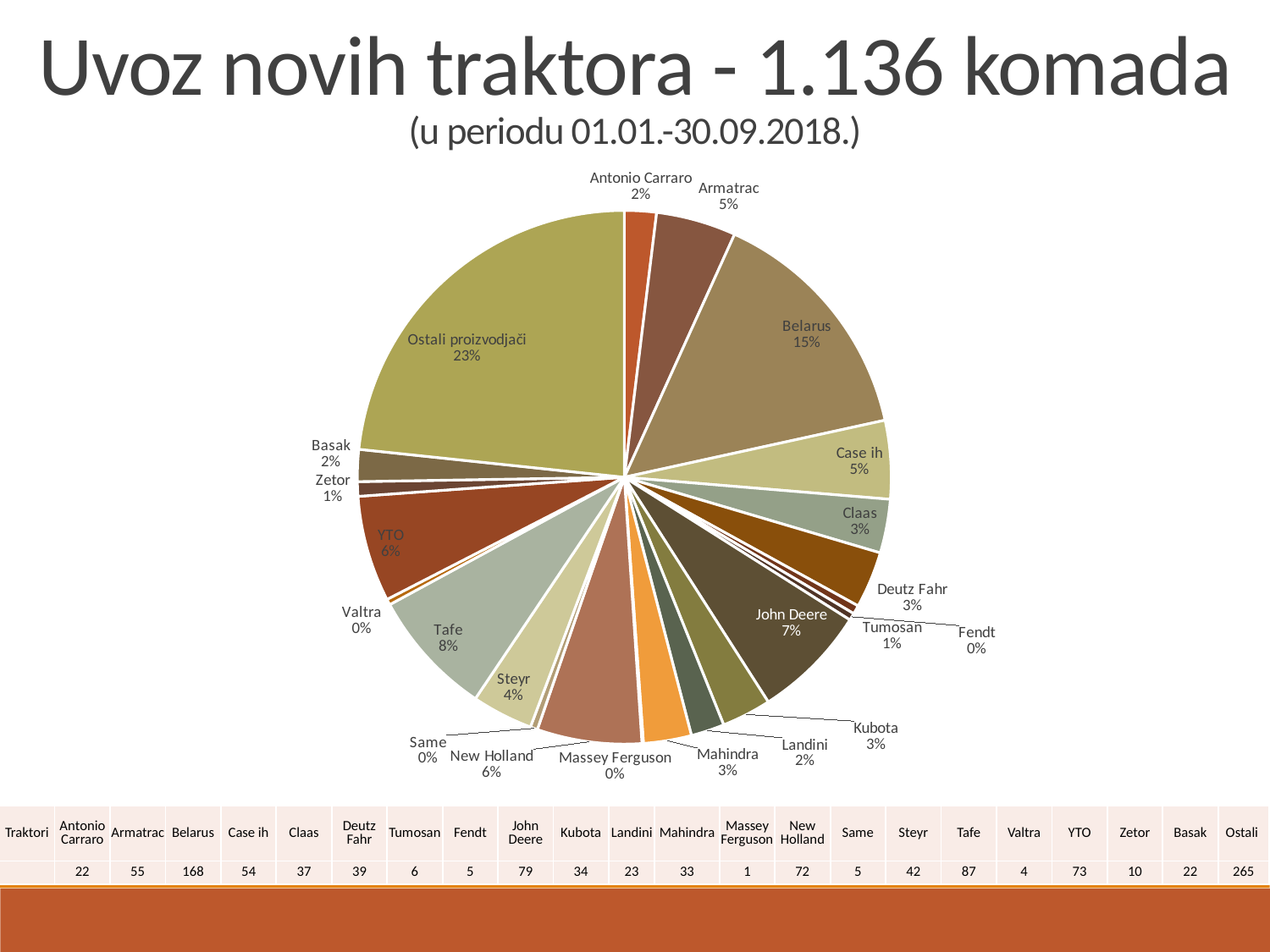
What share of the pie does John Deere hold? 7% Which category has the largest slice of the pie? Ostali proizvodjači What share of the pie does Ostali proizvodjači hold? 23% What share of the pie does Belarus hold? 15% What is the title of the slide? Uvoz novih traktora - 1.136 komada According to the data table, which brand has the lowest number of imported tractors? Massey Ferguson Which is larger in the data table, YTO or Steyr? YTO How many categories are shown in the pie chart? 22 According to the data table, how many tractors were imported for Tafe? 87 What kind of chart is shown on the slide? pie chart According to the data table, how many tractors were imported for New Holland? 72 What is the difference between the Belarus and Tafe values in the data table? 81